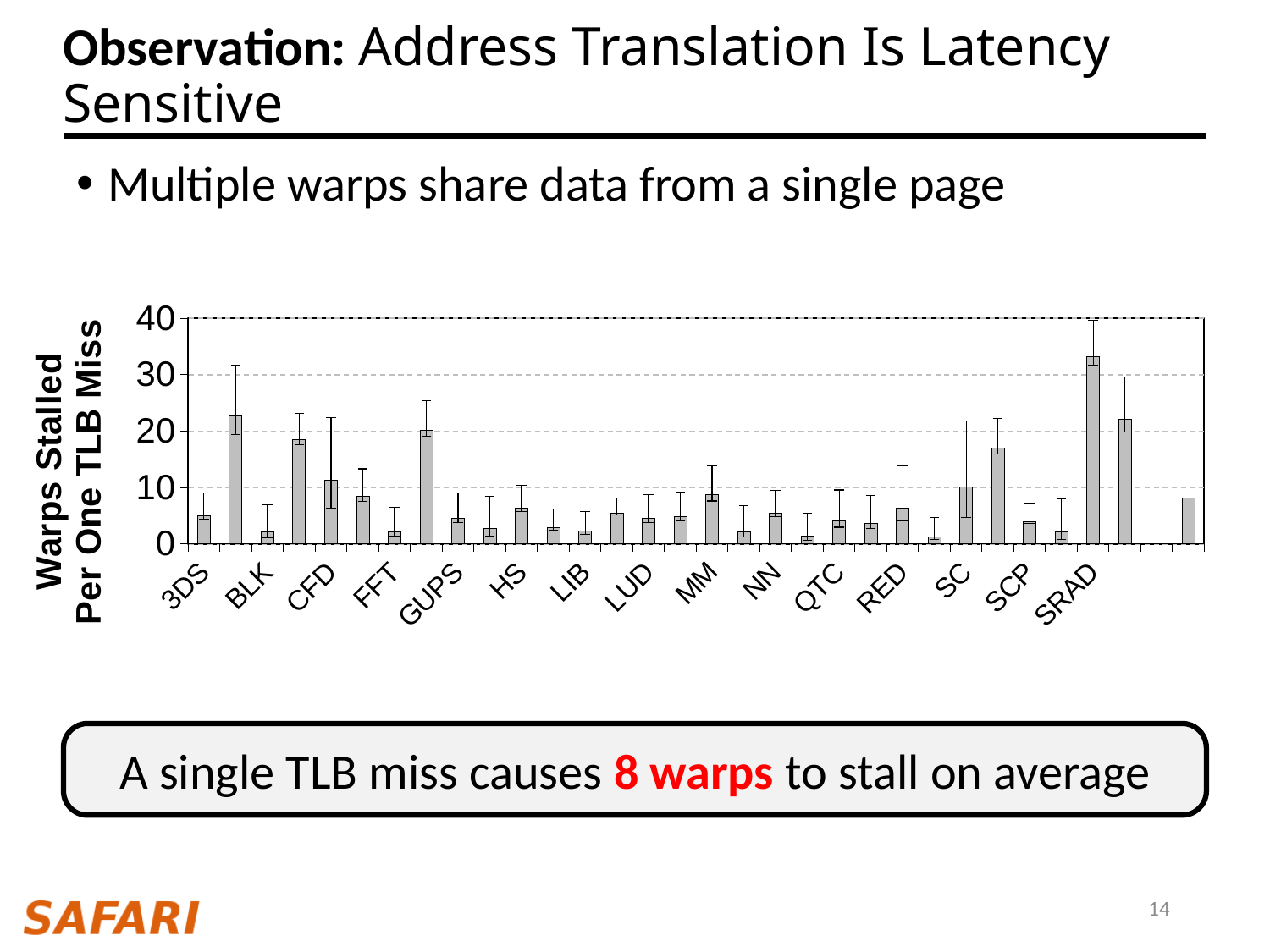
Is the tallest bar in the chart greater or less than 30? greater According to the slide, how many warps does a single TLB miss cause to stall on average? 8 warps What is the label of the y axis of the chart? Warps Stalled Per One TLB Miss What kind of chart is shown on the slide? bar chart Is the tallest bar in the chart greater or less than 40? less What is the highest tick value shown on the y axis? 40 How many category labels are printed along the x axis of the chart? 15 Is the value for 3DS greater or less than 10? less